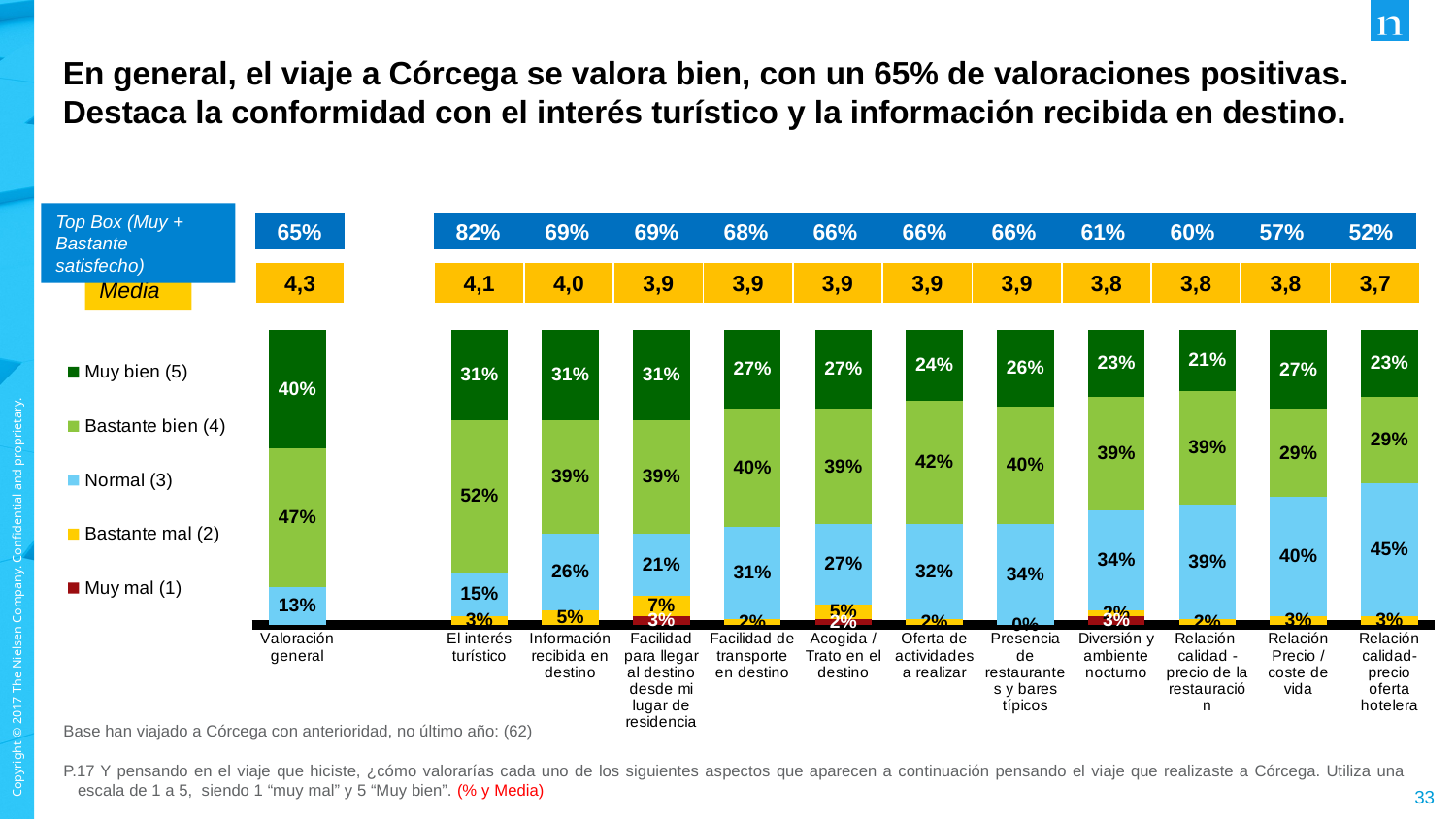
What is the Top Box value shown for 'El interés turístico'? 82% What is the difference in 'Muy bien (5)' percentage between 'Valoración general' and 'El interés turístico'? 9 percentage points How many categories (aspects) are plotted along the x axis? 12 Which category has the highest 'Normal (3)' percentage? Relación calidad-precio oferta hotelera Which has a larger 'Normal (3)' percentage: 'Relación Precio / coste de vida' or 'Relación calidad-precio oferta hotelera'? Relación calidad-precio oferta hotelera What is the 'Normal (3)' percentage for 'Relación calidad-precio oferta hotelera'? 45% What is the Media value shown for 'Valoración general'? 4,3 What is the 'Bastante bien (4)' percentage for 'El interés turístico'? 52% What is the 'Muy bien (5)' percentage for 'Valoración general'? 40% Which category has the highest 'Muy bien (5)' percentage? Valoración general What kind of chart is shown on the slide? Stacked bar chart How many series does the legend list? 5